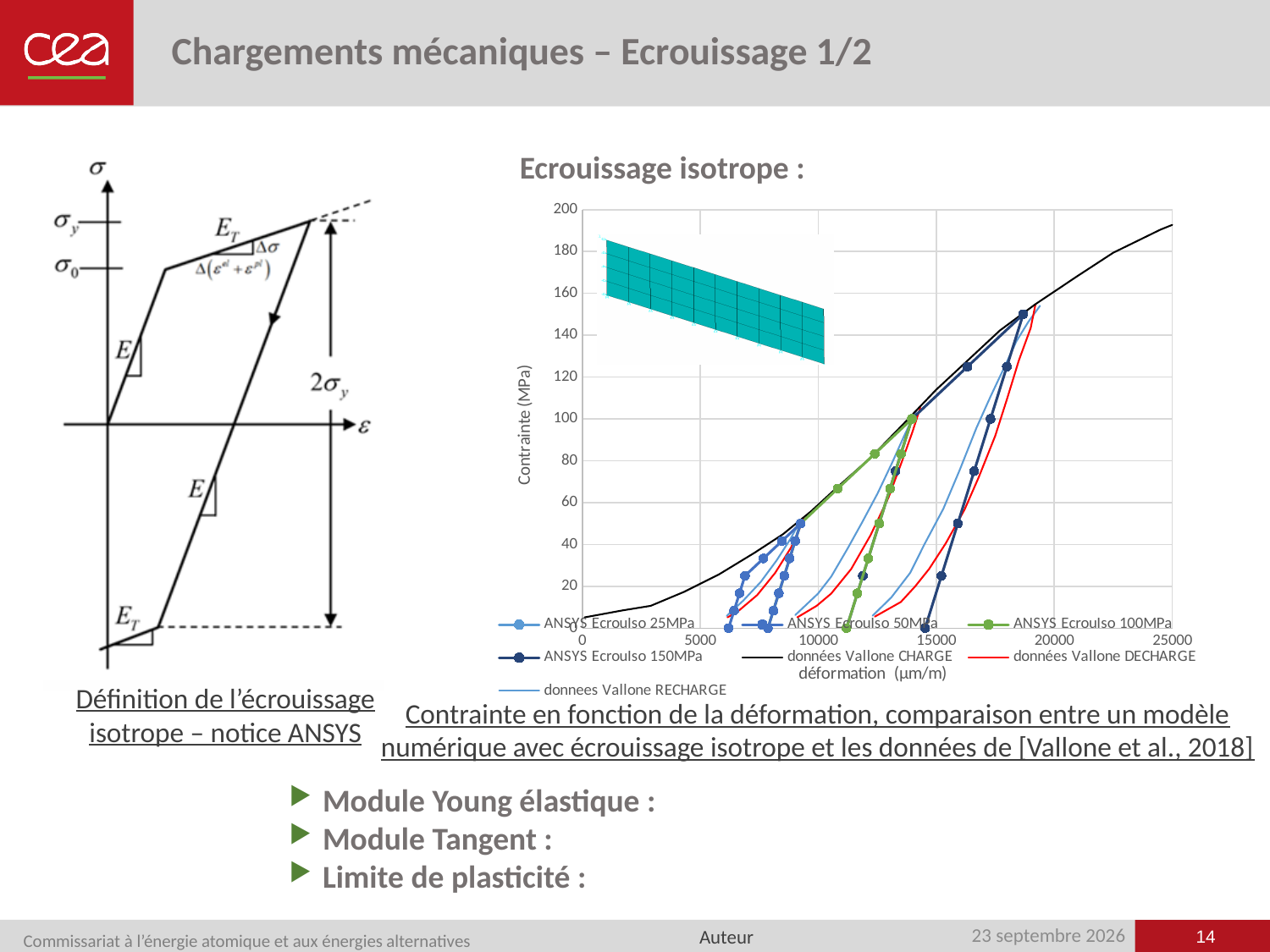
What kind of chart is the 'Ecrouissage isotrope' chart? line chart On the 'Ecrouissage isotrope' chart, is the maximum stress reached by the 'ANSYS Ecroulso 50MPa' series greater or less than 80? less On the 'Ecrouissage isotrope' chart, is the value of the 'données Vallone CHARGE' curve at 25000 µm/m greater or less than 180? greater On the 'Ecrouissage isotrope' chart, is the maximum stress reached by the 'ANSYS Ecroulso 150MPa' series greater or less than 140? greater How many series does the legend of the 'Ecrouissage isotrope' chart list? 7 On the 'Ecrouissage isotrope' chart, what is the title of the horizontal axis? déformation (µm/m) On the 'Ecrouissage isotrope' chart, which series reaches a higher maximum stress: 'ANSYS Ecroulso 150MPa' or 'ANSYS Ecroulso 100MPa'? ANSYS Ecroulso 150MPa On the 'Ecrouissage isotrope' chart, what is the highest value shown on the vertical axis? 200 On the 'Ecrouissage isotrope' chart, does the 'données Vallone CHARGE' curve rise or fall as deformation increases along the x axis? rise On the 'Ecrouissage isotrope' chart, what is the title of the vertical axis? Contrainte (MPa)